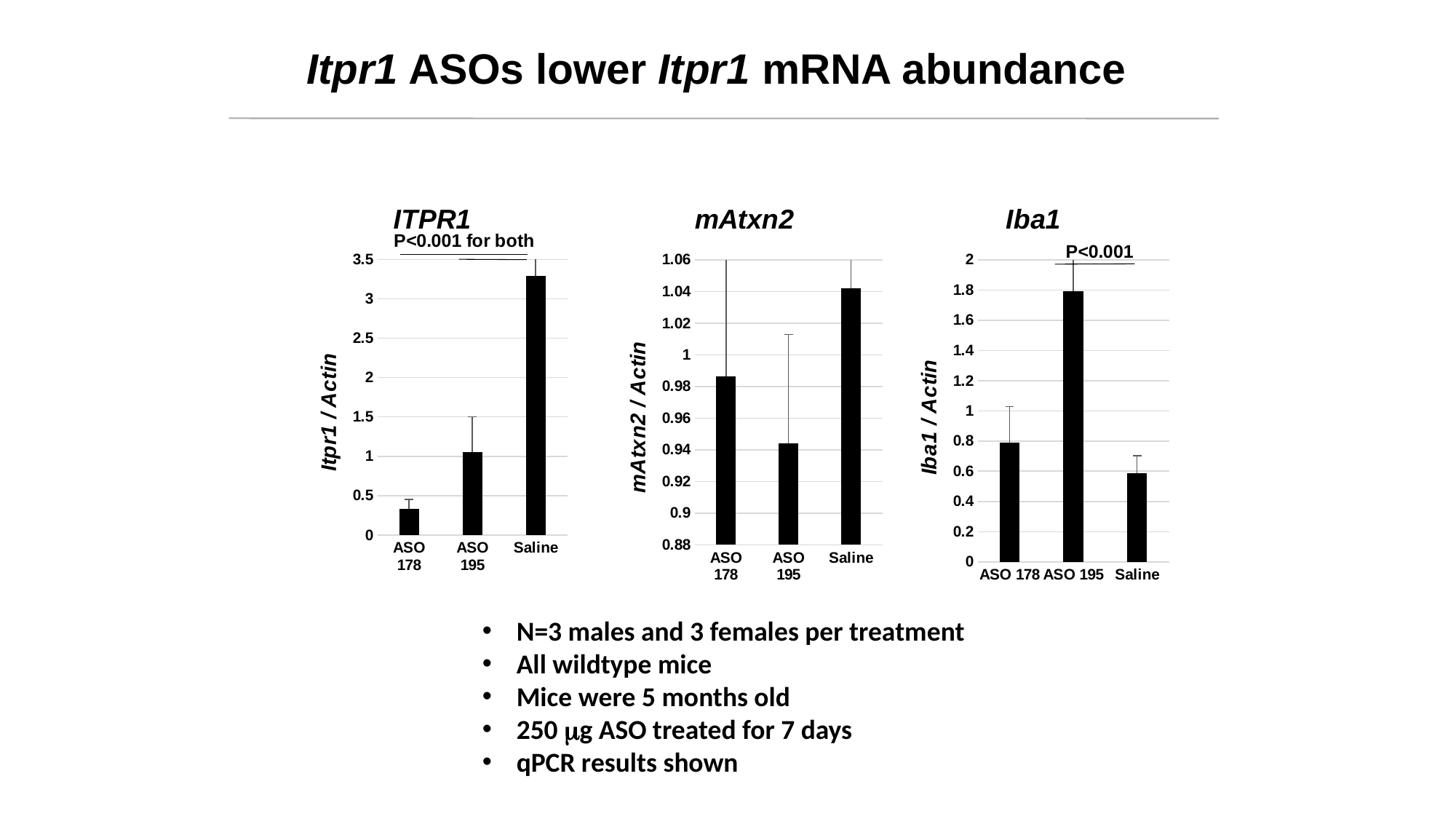
In the ITPR1 chart, which category has the lowest Itpr1 / Actin value? ASO 178 In the ITPR1 chart, is the value for ASO 178 greater or less than 0.5? less How many categories are shown on the x axis of the ITPR1 chart? 3 In the mAtxn2 chart, which category has the lowest mAtxn2 / Actin value? ASO 195 In the ITPR1 chart, is the value for Saline greater or less than 3? greater In the mAtxn2 chart, which category has the highest mAtxn2 / Actin value? Saline In the ITPR1 chart, which category has the highest Itpr1 / Actin value? Saline In the mAtxn2 chart, is the value for Saline greater or less than 1? greater In the Iba1 chart, which is larger, the value for ASO 178 or the value for Saline? ASO 178 In the Iba1 chart, which category has the lowest Iba1 / Actin value? Saline In the Iba1 chart, which category has the highest Iba1 / Actin value? ASO 195